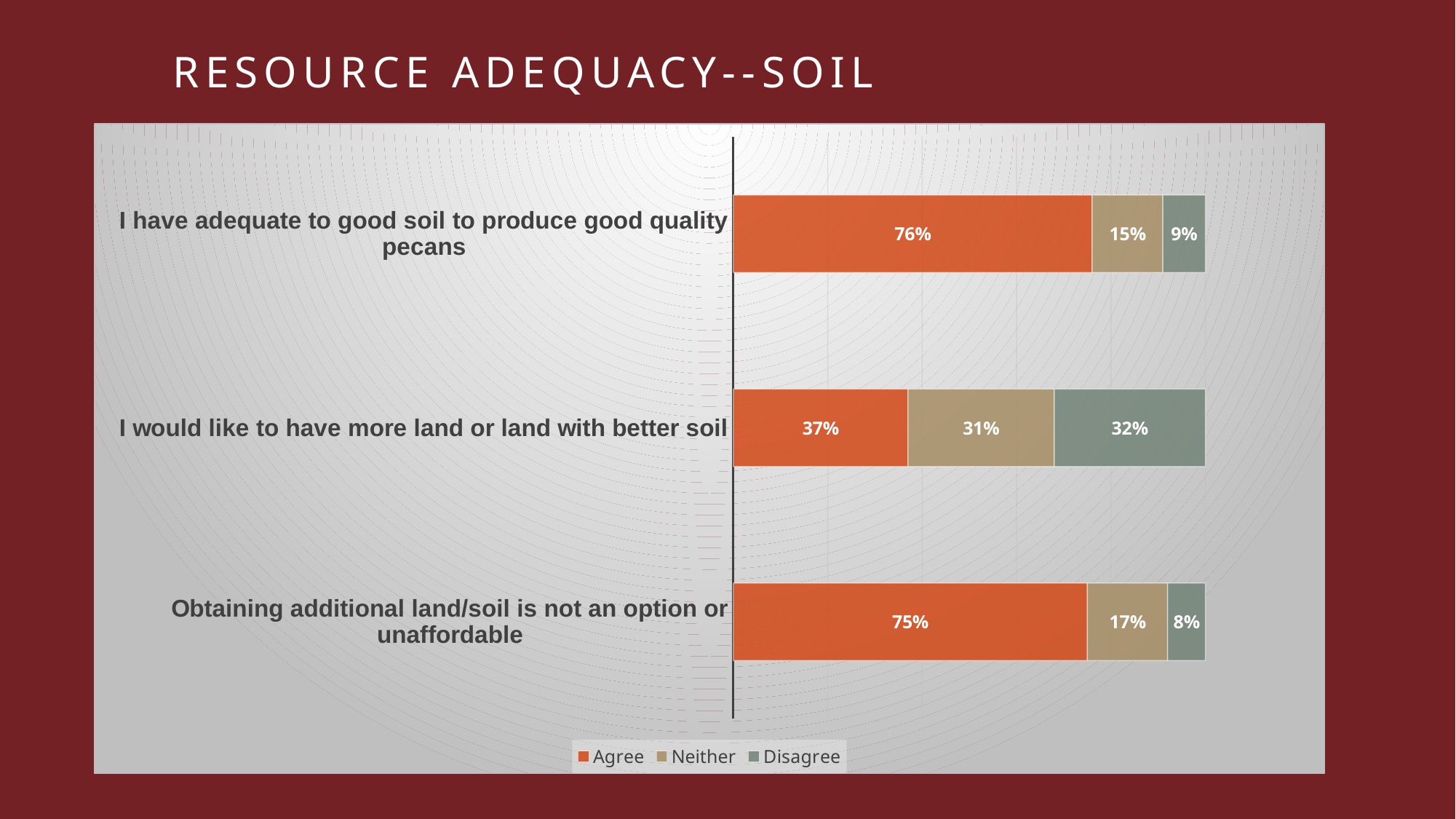
How many series does the legend list? 3 Which is larger: the Neither value for "I have adequate to good soil to produce good quality pecans" or the Neither value for "I would like to have more land or land with better soil"? I would like to have more land or land with better soil What kind of chart is shown on the slide? Stacked bar chart What is the difference between the Agree and Disagree percentages for "I would like to have more land or land with better soil"? 5% What percentage of respondents agree with the statement "I have adequate to good soil to produce good quality pecans"? 76% Which series is shown in orange in the legend? Agree Which statement has the highest Agree percentage? I have adequate to good soil to produce good quality pecans What percentage of respondents disagree with the statement "I would like to have more land or land with better soil"? 32% What is the total of the stacked bar for "Obtaining additional land/soil is not an option or unaffordable"? 100% What is the Neither value for "Obtaining additional land/soil is not an option or unaffordable"? 17% How many statements (categories) are shown in the chart? 3 Which statement has the lowest Agree percentage? I would like to have more land or land with better soil